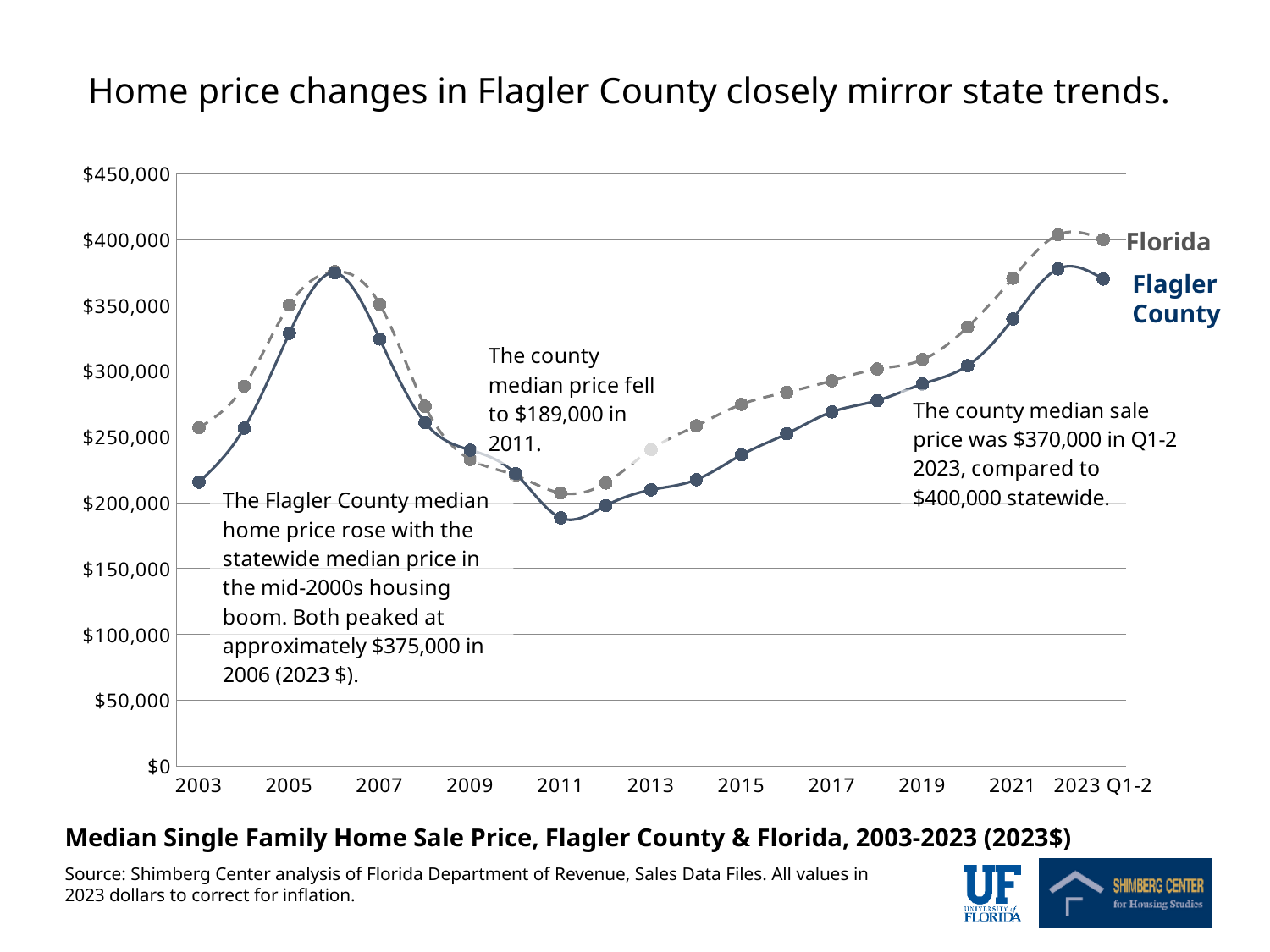
Is the Flagler County value for 2007 greater or less than $300,000? greater What kind of chart is shown on the slide? line chart What was the Florida statewide median sale price in Q1-2 2023? $400,000 What was the Flagler County median sale price in Q1-2 2023? $370,000 How many series are plotted on the chart? 2 Is the Flagler County value for 2003 greater or less than $250,000? less In 2005, which series has the higher median sale price, Florida or Flagler County? Florida How much higher was the Florida median sale price than the Flagler County median in Q1-2 2023? $30,000 What was the Flagler County median home price in 2011? $189,000 What is the title of the chart? Median Single Family Home Sale Price, Flagler County & Florida, 2003-2023 (2023$) In which year does the Flagler County series reach its lowest value? 2011 In 2023 Q1-2, which series has the higher median sale price, Florida or Flagler County? Florida